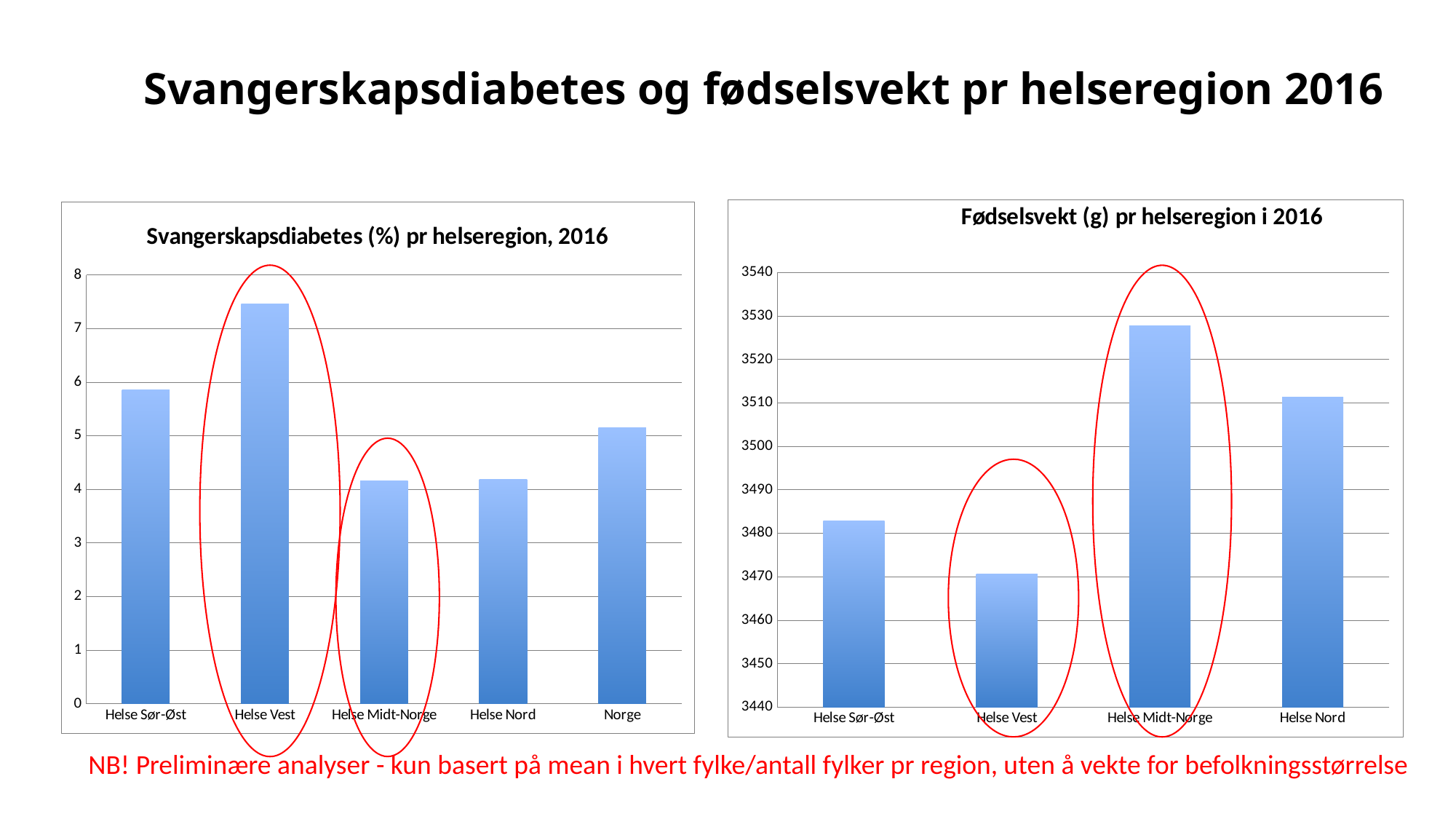
What kind of chart is the left chart on the slide? Bar chart In the chart titled "Svangerskapsdiabetes (%) pr helseregion, 2016", which is larger, the value for Helse Sør-Øst or the value for Norge? Helse Sør-Øst In the chart titled "Fødselsvekt (g) pr helseregion i 2016", which category has the lowest value? Helse Vest In the chart titled "Svangerskapsdiabetes (%) pr helseregion, 2016", is the value for Helse Vest greater or less than 7? greater In the chart titled "Svangerskapsdiabetes (%) pr helseregion, 2016", which category has the highest value? Helse Vest In the chart titled "Fødselsvekt (g) pr helseregion i 2016", which is larger, the value for Helse Sør-Øst or the value for Helse Vest? Helse Sør-Øst In the chart titled "Fødselsvekt (g) pr helseregion i 2016", how many categories are shown on the x axis? 4 What is the title of the right chart on the slide? Fødselsvekt (g) pr helseregion i 2016 In the chart titled "Fødselsvekt (g) pr helseregion i 2016", which category has the highest value? Helse Midt-Norge In the chart titled "Svangerskapsdiabetes (%) pr helseregion, 2016", is the value for Helse Sør-Øst greater or less than 6? less In the chart titled "Fødselsvekt (g) pr helseregion i 2016", is the value for Helse Nord greater or less than 3500? greater In the chart titled "Svangerskapsdiabetes (%) pr helseregion, 2016", how many categories are shown on the x axis? 5